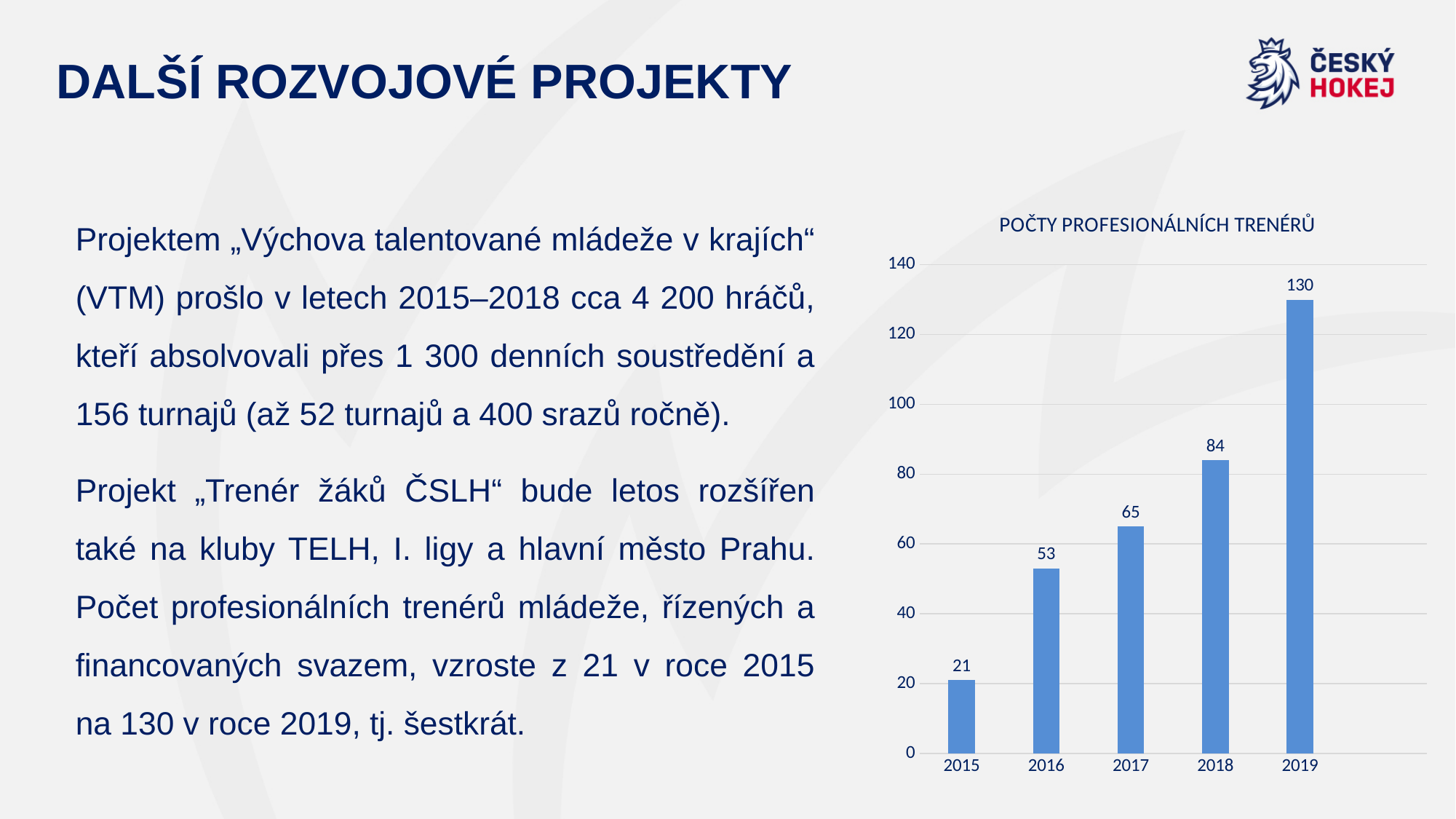
Is the value for 2018 greater or less than 100? less What is the title of the chart? POČTY PROFESIONÁLNÍCH TRENÉRŮ What is the value for 2015 in the chart? 21 Which year has the lowest value in the chart? 2015 Which year has the highest value in the chart? 2019 What kind of chart is shown on the slide? bar chart How many years are shown on the x axis of the chart? 5 What is the difference between the values for 2018 and 2017? 19 Which is larger, the value for 2016 or the value for 2018? 2018 What is the value for 2017 in the chart? 65 What is the value for 2019 in the chart? 130 What is the difference between the values for 2019 and 2015? 109